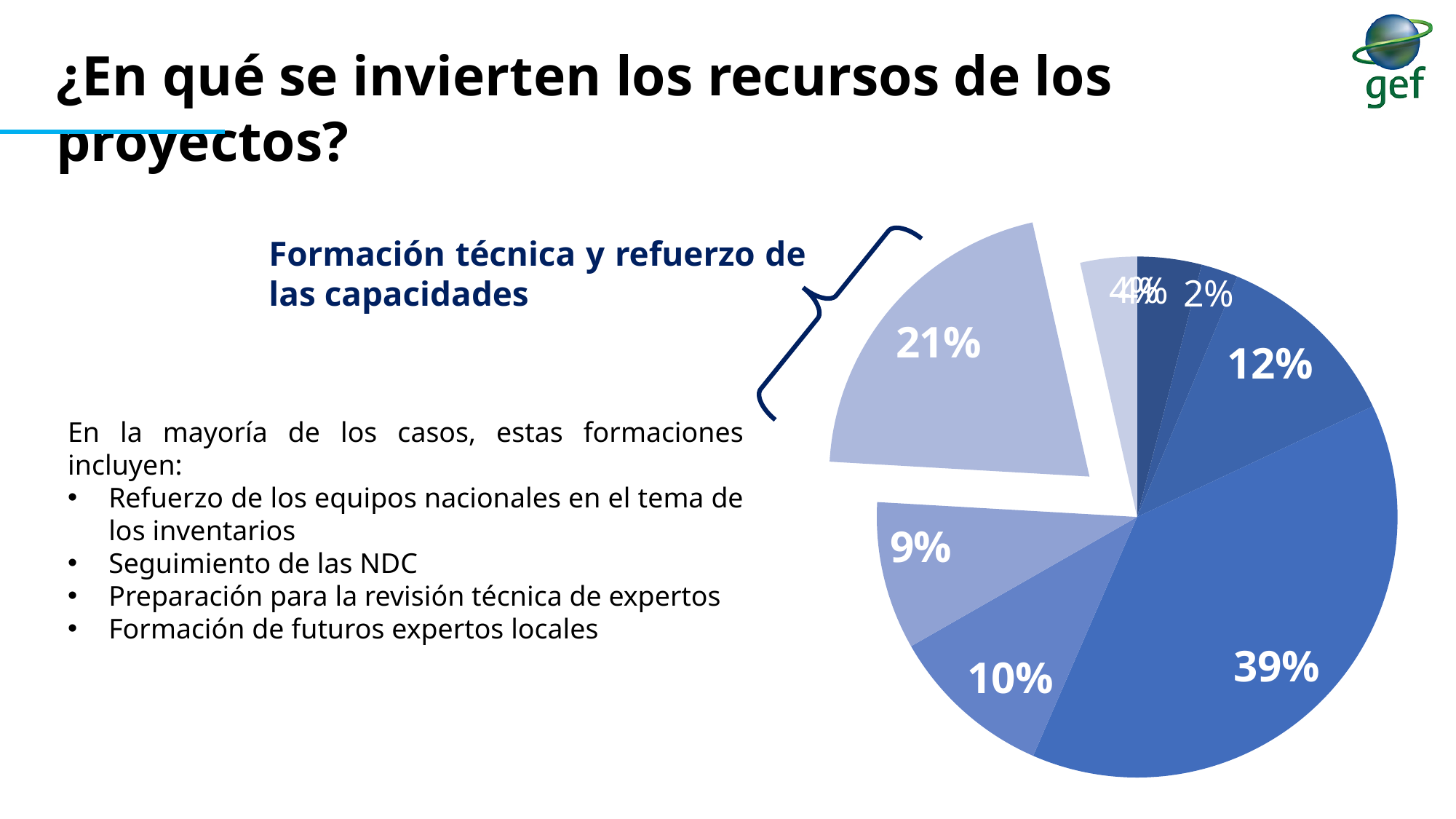
Which slice of the pie chart is pulled out (exploded) from the rest? the 21% slice (Formación técnica y refuerzo de las capacidades) What is the value shown on the largest slice of the pie chart? 39% What kind of chart is shown on the slide? pie chart Which is larger: the slice for "Formación técnica y refuerzo de las capacidades" or the largest slice of the pie? the largest slice (39%) By how many percentage points does the largest slice (39%) exceed the "Formación técnica y refuerzo de las capacidades" slice (21%)? 18 percentage points What is the smallest clearly readable percentage label on the pie chart? 2% Is the share of the "Formación técnica y refuerzo de las capacidades" slice greater or less than 20%? greater What share of the pie does the slice labelled "Formación técnica y refuerzo de las capacidades" represent? 21% Does the pie chart include a legend? No